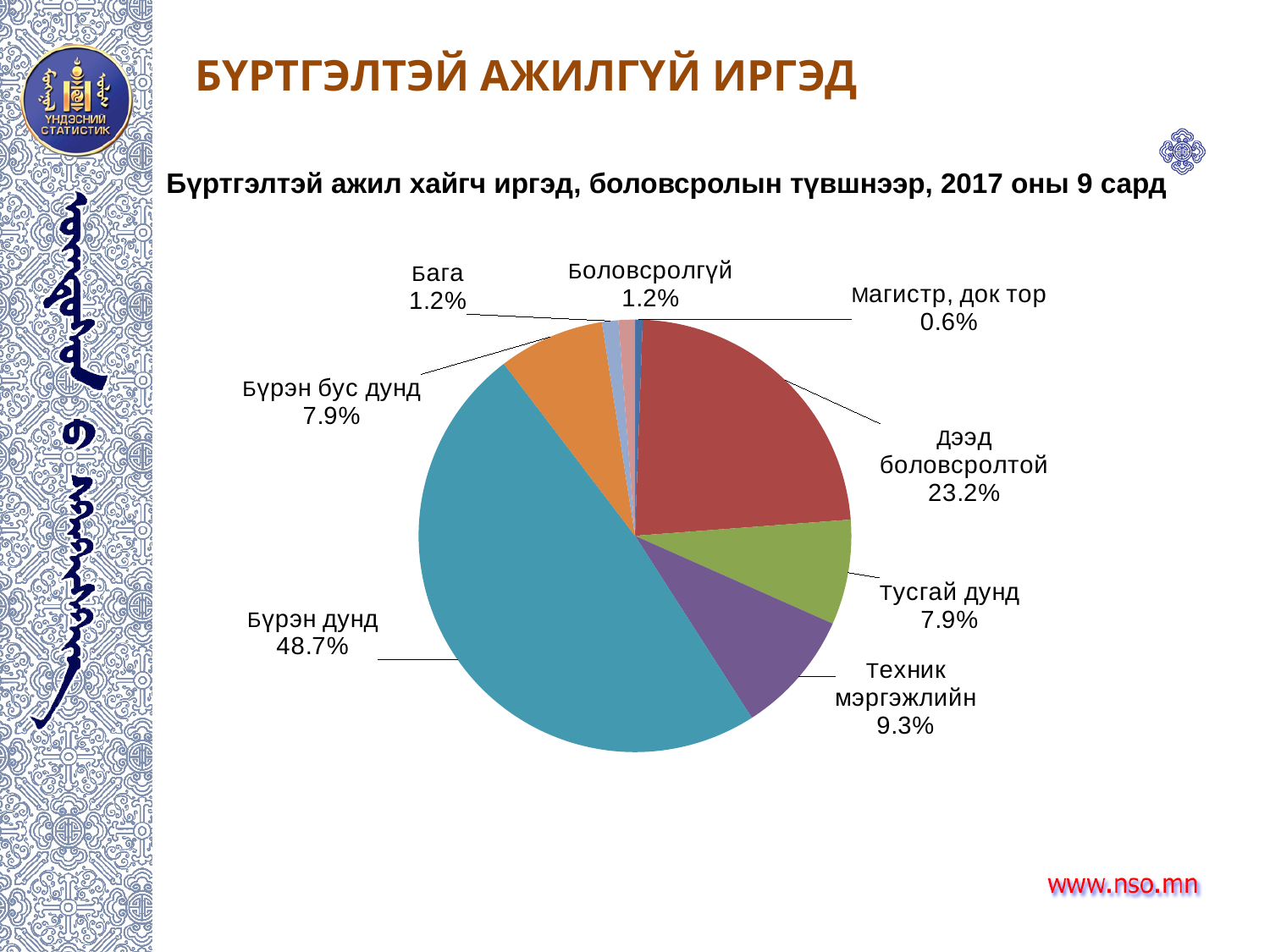
How many slices does the pie chart have? 8 What is the title of the chart? Бүртгэлтэй ажил хайгч иргэд, боловсролын түвшнээр, 2017 оны 9 сард Which category has the largest slice of the pie? Бүрэн дунд What is the value shown for Магистр, док тор? 0.6% What share of the pie does Бүрэн дунд have? 48.7% Which is larger, the value for Техник мэргэжлийн or the value for Тусгай дунд? Техник мэргэжлийн What is the value shown for Техник мэргэжлийн? 9.3% What is the value shown for Бүрэн бус дунд? 7.9% Which category has the smallest slice of the pie? Магистр, док тор What kind of chart is shown on the slide? Pie chart What is the difference between the values for Бүрэн дунд and Дээд боловсролтой? 25.5% What is the value shown for Дээд боловсролтой? 23.2%